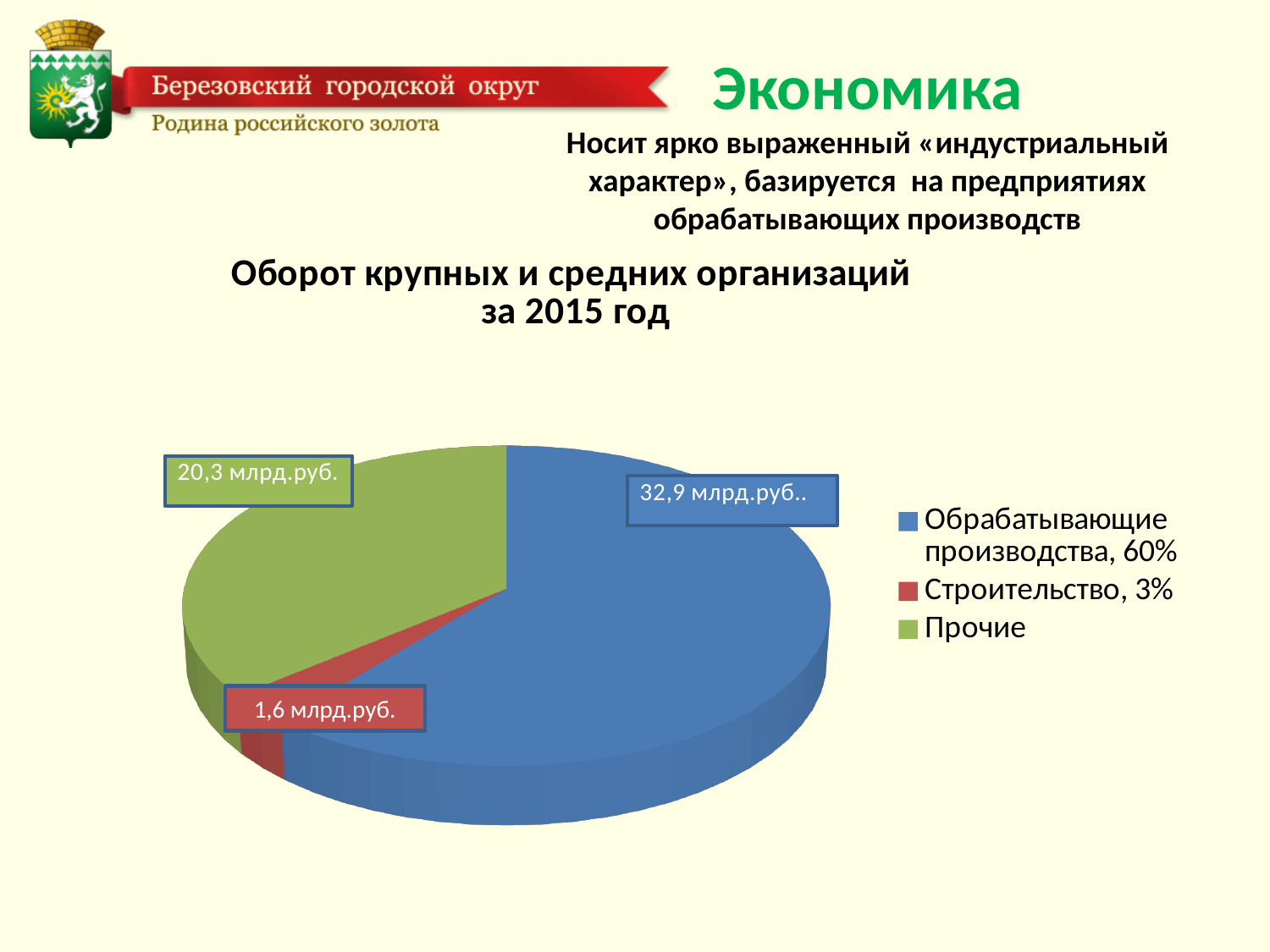
Which category has the smallest slice of the pie? Строительство What is the difference between the values for Обрабатывающие производства and Прочие? 12,6 млрд.руб. How many categories are shown in the pie chart? 3 What is the value shown for Строительство? 1,6 млрд.руб. What type of chart is shown on the slide? Pie chart What share of the pie does Обрабатывающие производства account for, according to the legend? 60% What is the difference between the values for Прочие and Строительство? 18,7 млрд.руб. What is the value shown for Обрабатывающие производства? 32,9 млрд.руб. What share of the pie does Строительство account for, according to the legend? 3% Which is larger, the value for Прочие or the value for Строительство? Прочие Which category has the largest slice of the pie? Обрабатывающие производства What is the value shown for Прочие? 20,3 млрд.руб.